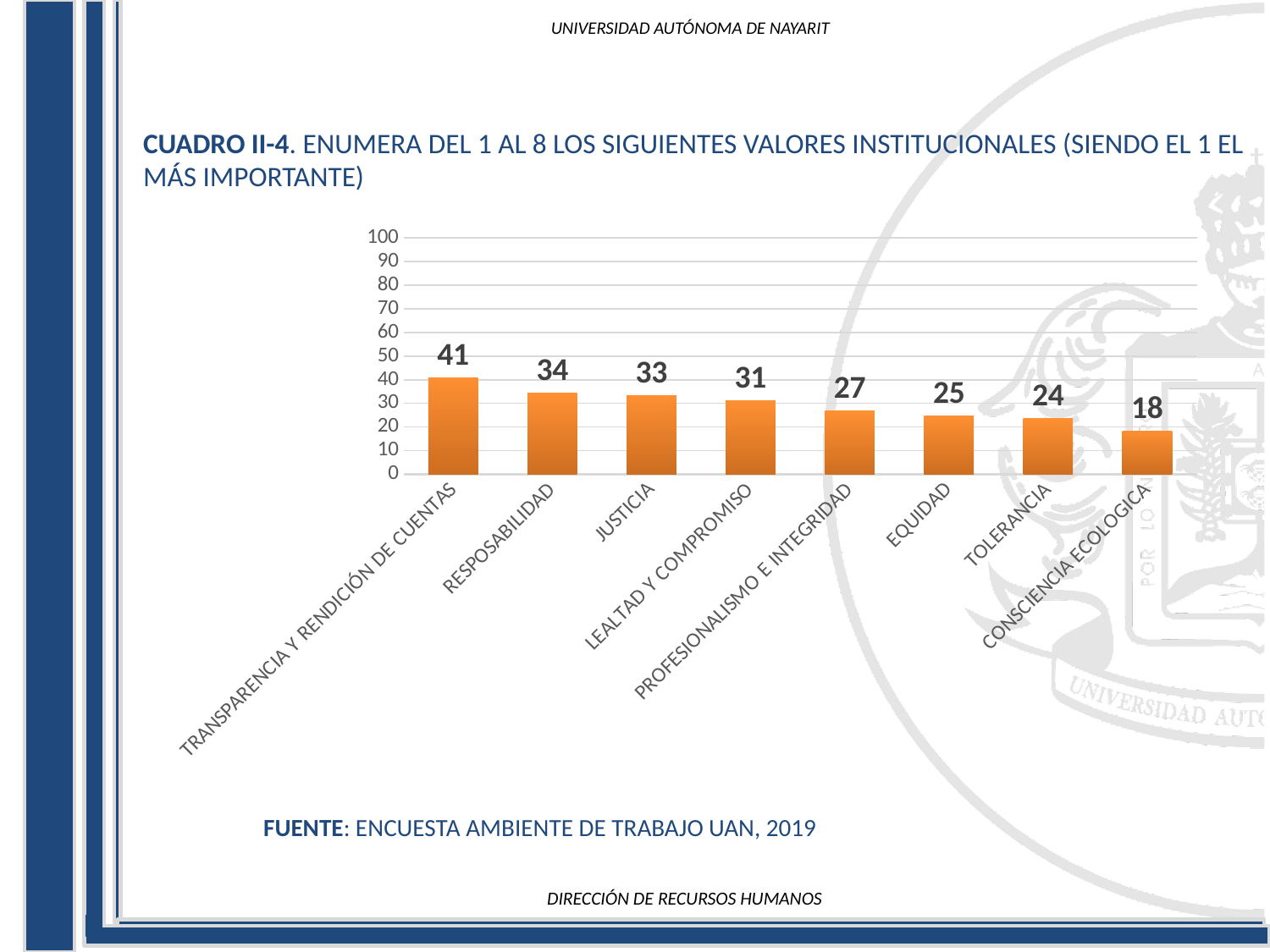
What is the difference between the values for RESPOSABILIDAD and LEALTAD Y COMPROMISO? 3 What is the difference between the values for TRANSPARENCIA Y RENDICIÓN DE CUENTAS and CONSCIENCIA ECOLOGICA? 23 What is the value for JUSTICIA? 33 How many categories are shown on the x axis? 8 Do the values rise or fall from left to right along the x axis? fall What kind of chart is shown on the slide? bar chart Is the value for LEALTAD Y COMPROMISO greater or less than 50? less Which category has the lowest value? CONSCIENCIA ECOLOGICA Which is larger, the value for PROFESIONALISMO E INTEGRIDAD or the value for TOLERANCIA? PROFESIONALISMO E INTEGRIDAD What is the value for TOLERANCIA? 24 What is the value for EQUIDAD? 25 Which category has the highest value? TRANSPARENCIA Y RENDICIÓN DE CUENTAS